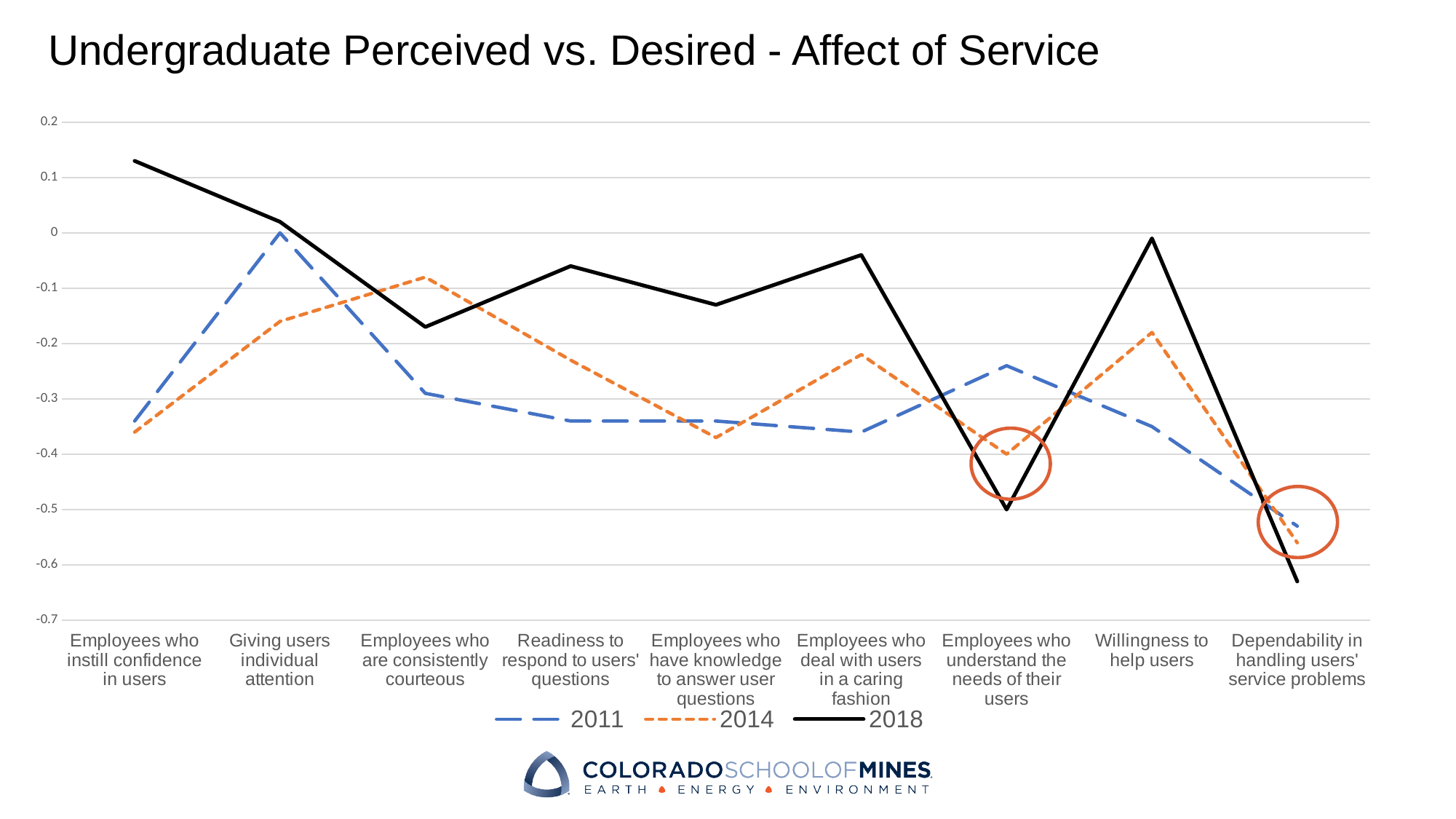
How many series does the legend list? 3 Is the 2011 value for 'Employees who deal with users in a caring fashion' greater or less than -0.3? less For 'Willingness to help users', which series has the larger value, 2011 or 2018? 2018 Is the 2018 value for 'Employees who understand the needs of their users' greater or less than -0.4? less Between 'Willingness to help users' and 'Dependability in handling users' service problems', does the 2018 line rise or fall? fall For the 2018 series, which category has the highest value? Employees who instill confidence in users For the 2014 series, which category has the highest value? Employees who are consistently courteous For the 2014 series, which category has the lowest value? Dependability in handling users' service problems Is the 2018 value for 'Employees who instill confidence in users' greater or less than 0? greater For the 2018 series, which category has the lowest value? Dependability in handling users' service problems What kind of chart is shown on the slide? line chart How many categories are plotted along the x axis? 9